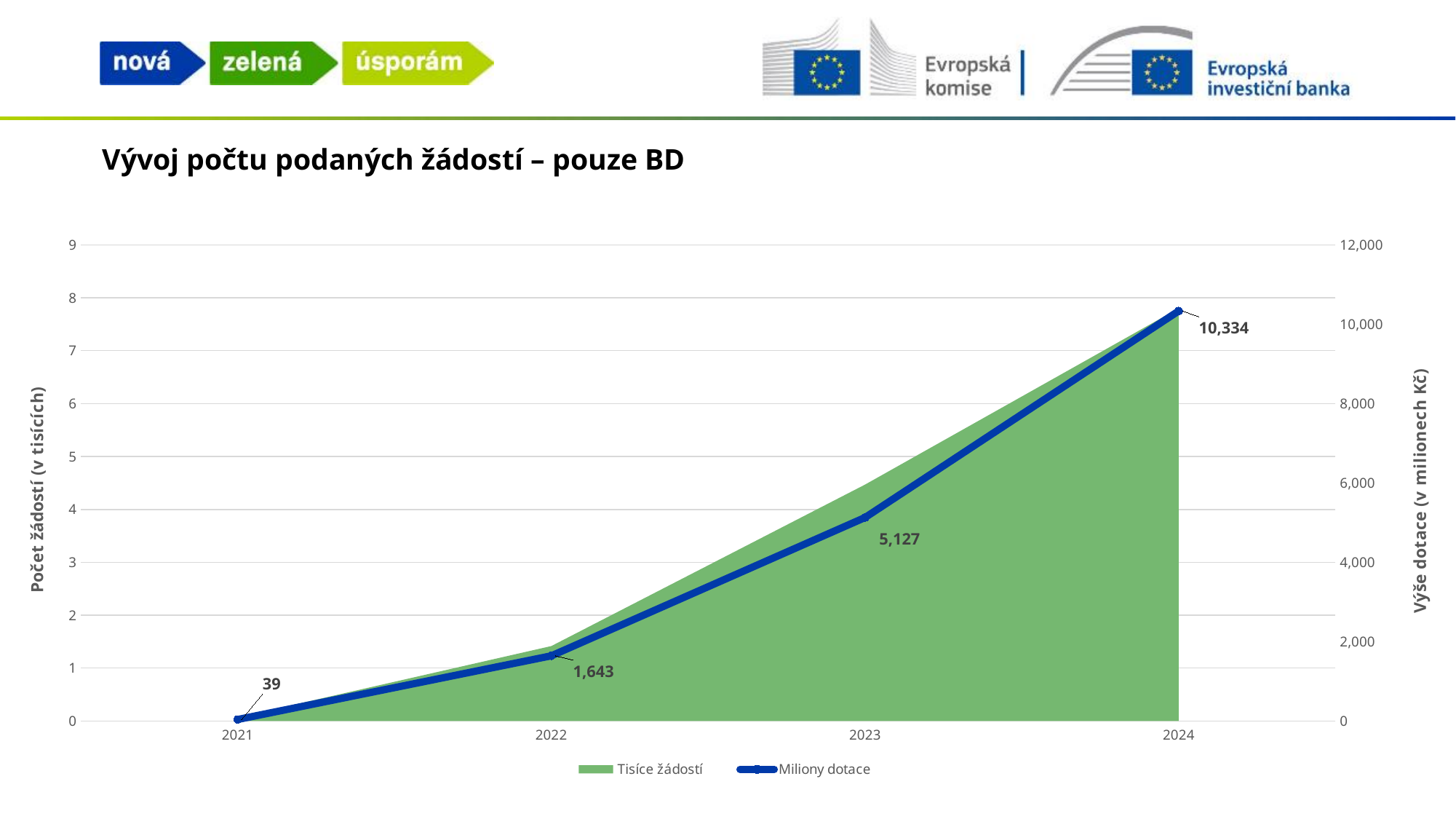
Is the Tisíce žádostí value for 2022 greater or less than 2? less Which year has the larger Miliony dotace value, 2022 or 2023? 2023 What is the difference between the Miliony dotace values for 2024 and 2023? 5,207 What is the value of Miliony dotace for 2024? 10,334 Which year has the highest value of Miliony dotace? 2024 How many years are shown on the x axis? 4 How many series does the legend list? 2 Do the Miliony dotace values rise or fall from 2021 to 2024? rise Is the Tisíce žádostí value for 2024 greater or less than 6? greater Which year has the lowest value of Miliony dotace? 2021 What is the value of Miliony dotace for 2021? 39 What is the value of Miliony dotace for 2022? 1,643